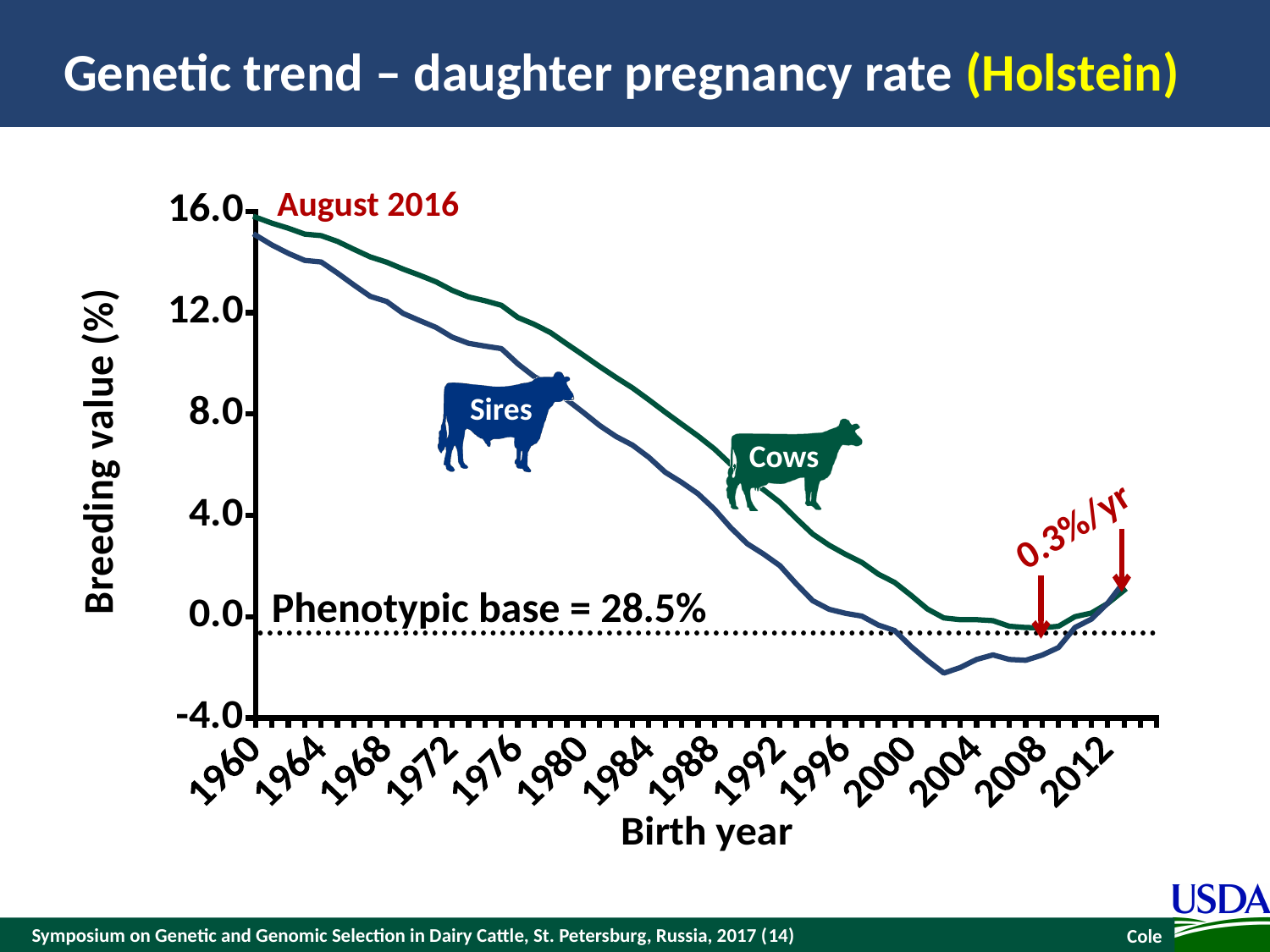
Do the breeding values for Sires rise or fall from 1960 to 2000? fall In 1984, which series has the higher breeding value, Sires or Cows? Cows Which series reaches the lowest breeding value on the chart? Sires How many series are plotted on the chart? 2 Is the breeding value for Sires in 1960 greater or less than 12.0? greater Is the breeding value for Cows in 1980 greater or less than 8.0? greater Is the breeding value for Cows in 1996 greater or less than 4.0? less What kind of chart is shown on the slide? line chart What is the phenotypic base stated on the chart? 28.5% Do the breeding values for Cows rise or fall between 2008 and 2012? rise Which two series are plotted on the chart? Sires and Cows